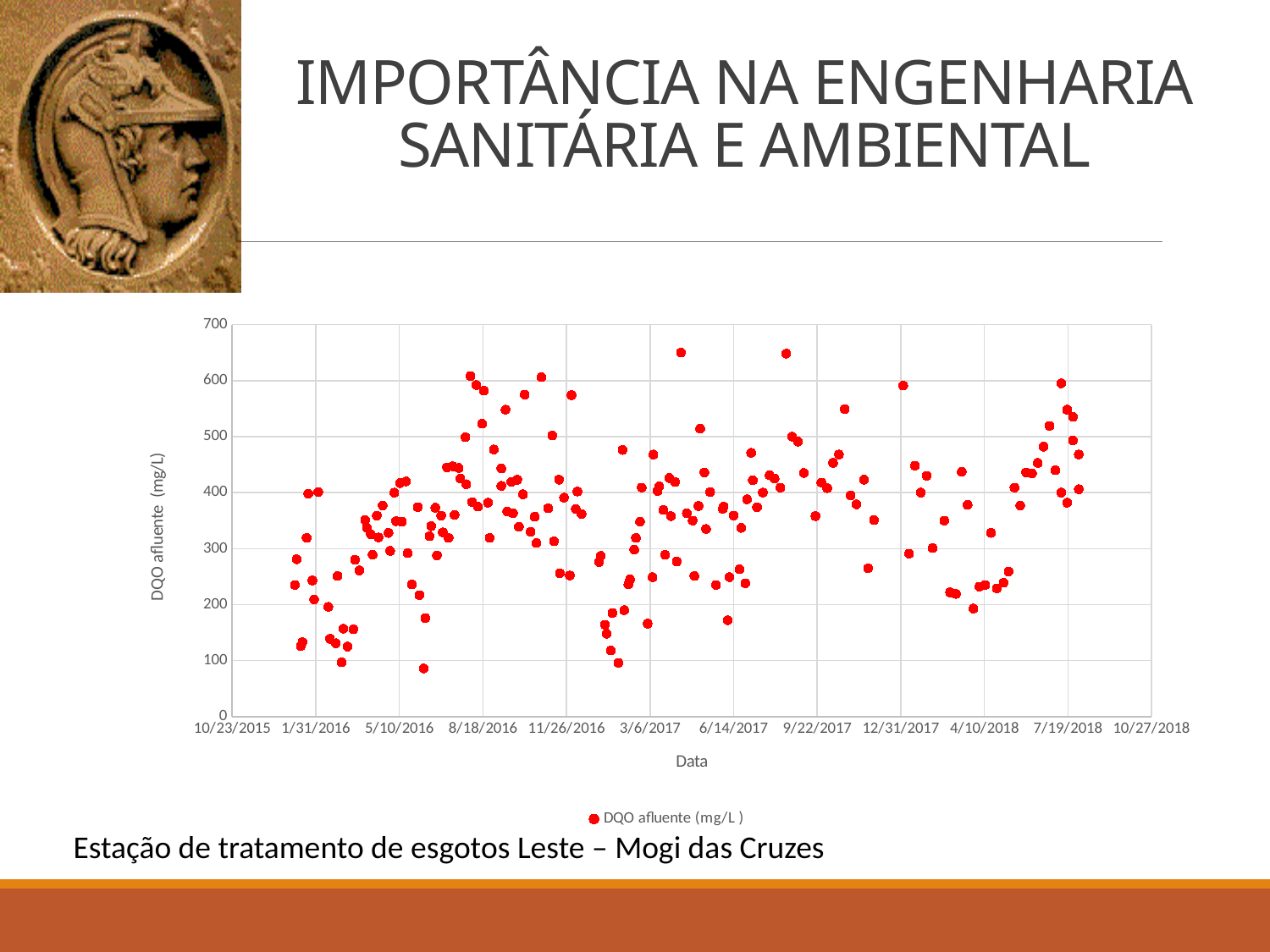
Is the highest plotted DQO afluente value greater or less than 700? less What kind of chart is shown on the slide? scatter chart How many series does the legend list? 1 Is the highest plotted DQO afluente value greater or less than 600? greater Is the lowest plotted DQO afluente value greater or less than 200? less What is the title of the vertical axis? DQO afluente (mg/L) What is the name of the series shown in the legend? DQO afluente (mg/L )